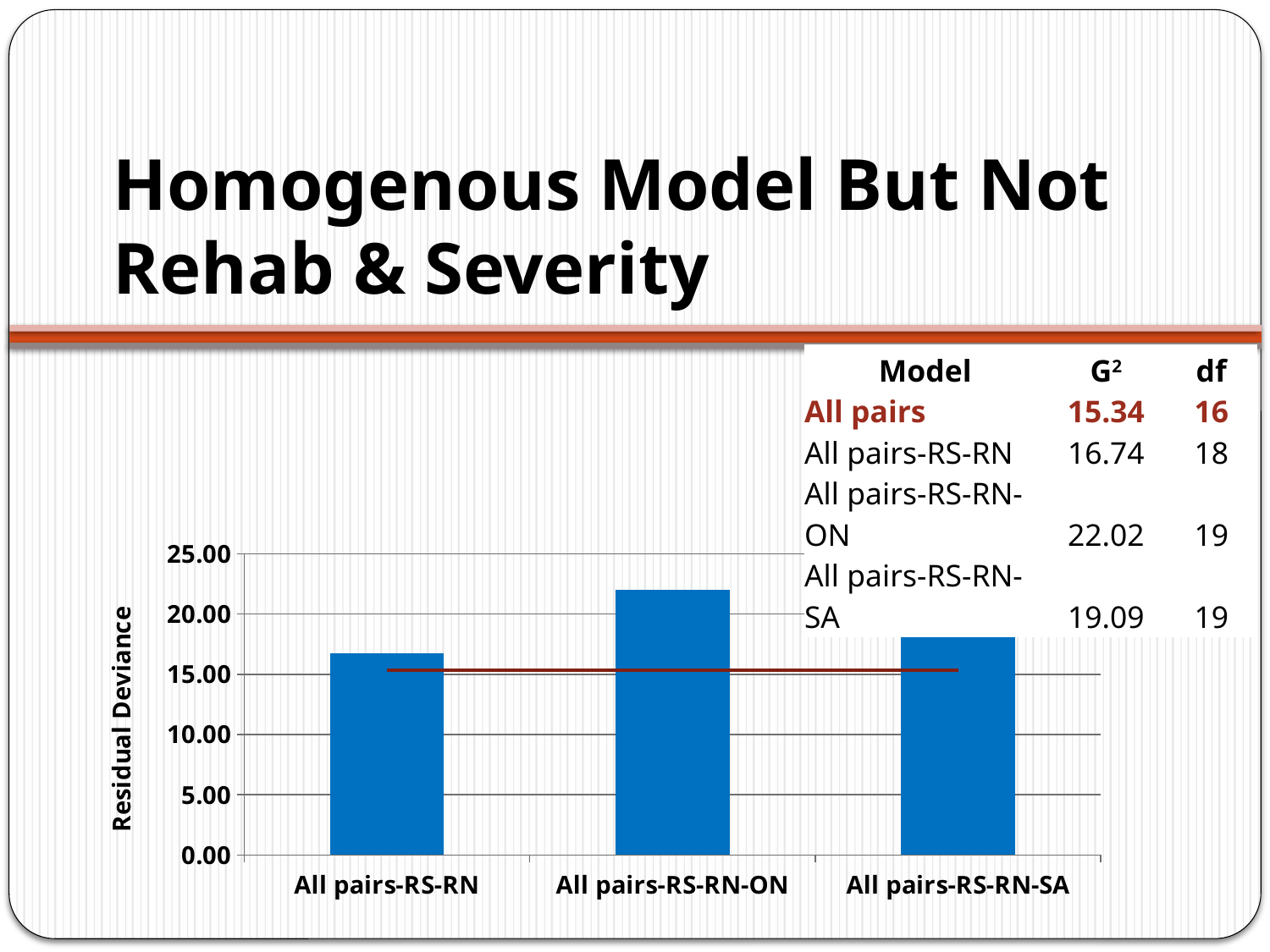
Is the value for All pairs-RS-RN greater or less than 20.00? less Which is larger, the bar for All pairs-RS-RN-ON or the bar for All pairs-RS-RN-SA? All pairs-RS-RN-ON Is the value for All pairs-RS-RN-SA greater or less than 15.00? greater Which category has the highest residual deviance in the chart? All pairs-RS-RN-ON Which is larger, the bar for All pairs-RS-RN-SA or the bar for All pairs-RS-RN? All pairs-RS-RN-SA What is the title of the vertical axis of the chart? Residual Deviance What is the highest tick value shown on the vertical axis of the chart? 25.00 Is the value for All pairs-RS-RN greater or less than 15.00? greater How many bars (categories) are plotted in the chart? 3 Which category has the lowest residual deviance in the chart? All pairs-RS-RN What kind of chart is shown on the slide? bar chart